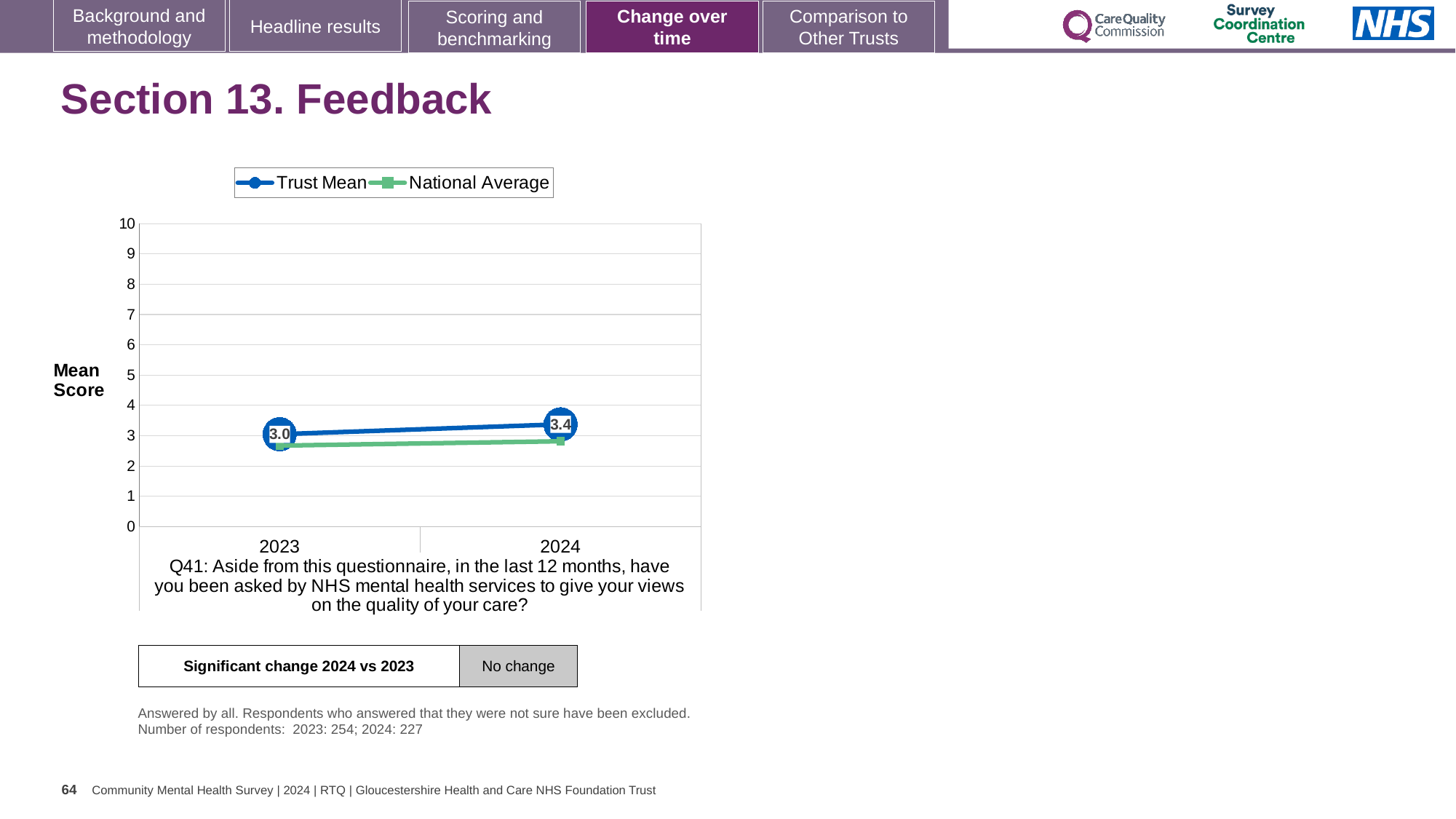
In 2024, which is larger: the Trust Mean or the National Average? Trust Mean Does the Trust Mean rise or fall from 2023 to 2024? rise How many years are plotted on the x axis? 2 Is the National Average value for 2023 greater or less than 3? less What is the Trust Mean value for 2023? 3.0 By how much did the Trust Mean change from 2023 to 2024? 0.4 What are the two series named in the legend? Trust Mean and National Average How many series does the legend list? 2 What kind of chart is shown on the slide? line chart In which year is the Trust Mean higher? 2024 What is the label on the y axis? Mean Score What is the Trust Mean value for 2024? 3.4